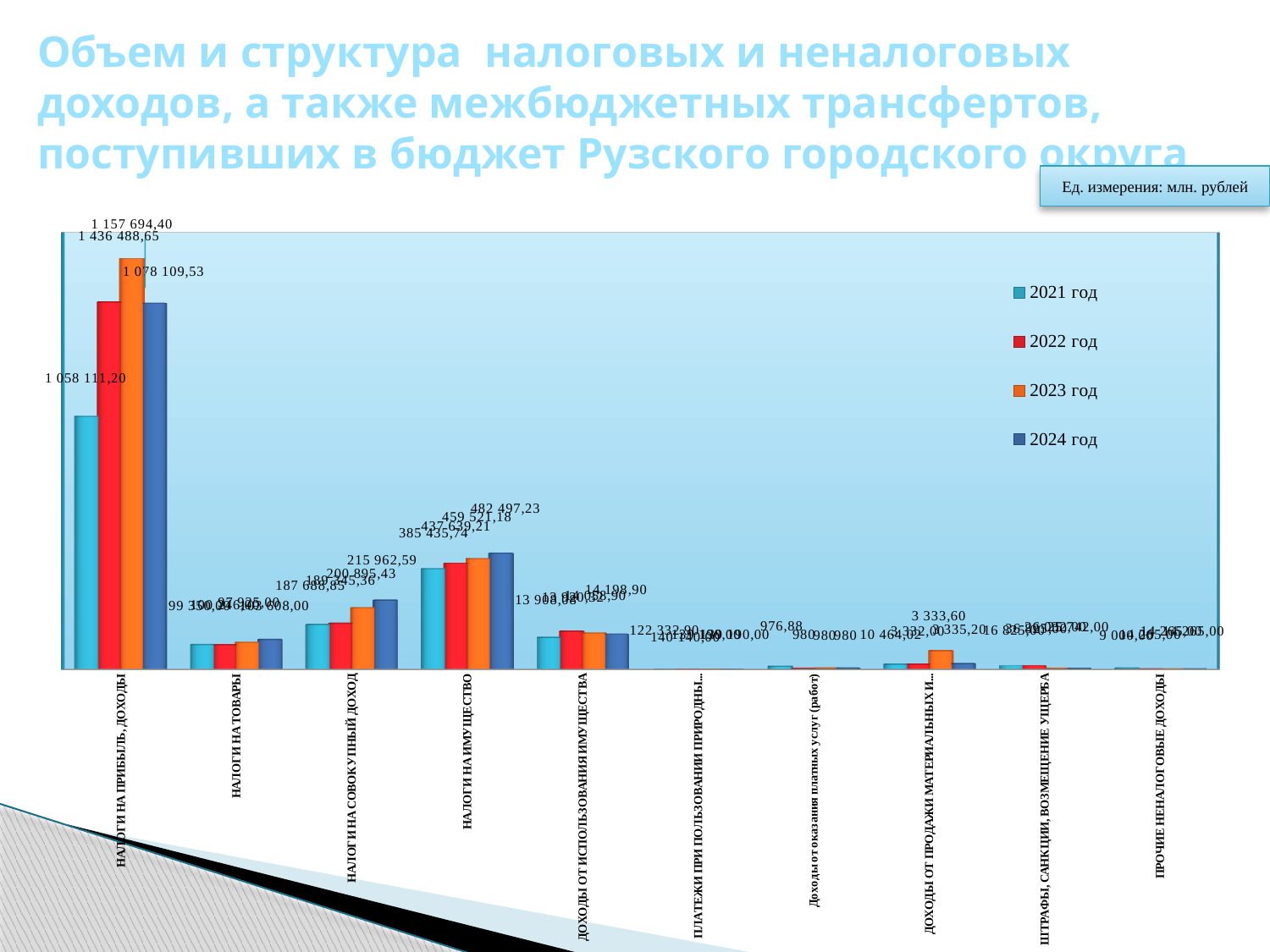
What is the value for 2021 год in the category НАЛОГИ НА ПРИБЫЛЬ, ДОХОДЫ? 1 058 111,20 Which category has the highest values in the chart? НАЛОГИ НА ПРИБЫЛЬ, ДОХОДЫ What is the value for 2024 год in the category НАЛОГИ НА СОВОКУПНЫЙ ДОХОД? 215 962,59 What kind of chart is shown on the slide? bar chart What is the value for 2021 год in the category НАЛОГИ НА ИМУЩЕСТВО? 385 435,74 How many series does the legend list? 4 How many categories are shown along the x axis? 10 Which is larger for НАЛОГИ НА ИМУЩЕСТВО: the value for 2021 год or for 2024 год? 2024 год What is the difference between the 2024 год and 2021 год values for НАЛОГИ НА ИМУЩЕСТВО? 97 061,49 What unit of measurement is stated for the chart? млн. рублей What is the value for 2024 год in the category НАЛОГИ НА ИМУЩЕСТВО? 482 497,23 Do the values for НАЛОГИ НА ИМУЩЕСТВО rise or fall from 2021 год to 2024 год? rise